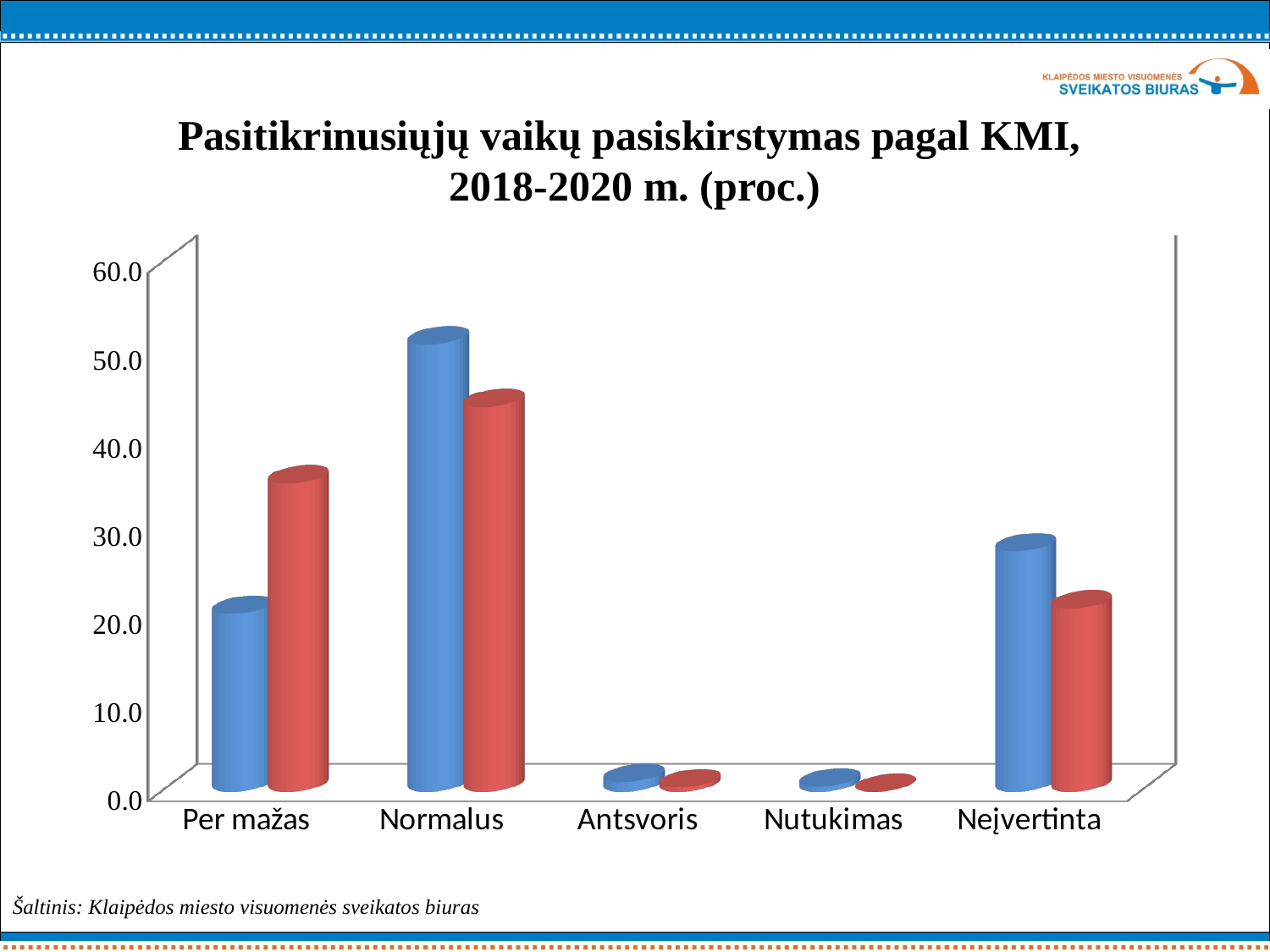
How many categories are shown on the x axis of the chart? 5 What is the title of the chart? Pasitikrinusiųjų vaikų pasiskirstymas pagal KMI, 2018-2020 m. (proc.) For the category Per mažas, which bar is taller, the blue one or the red one? the red one Which category has the tallest red bar? Normalus For the category Normalus, which bar is taller, the blue one or the red one? the blue one Is the value of the blue bar for Normalus greater or less than 40.0? greater Which category has the tallest bars in the chart? Normalus Which category has the tallest blue bar? Normalus Is the value of the blue bar for Antsvoris greater or less than 10.0? less Is the value of the red bar for Per mažas greater or less than 30.0? greater What kind of chart is shown on the slide? bar chart For the category Neįvertinta, which bar is taller, the blue one or the red one? the blue one